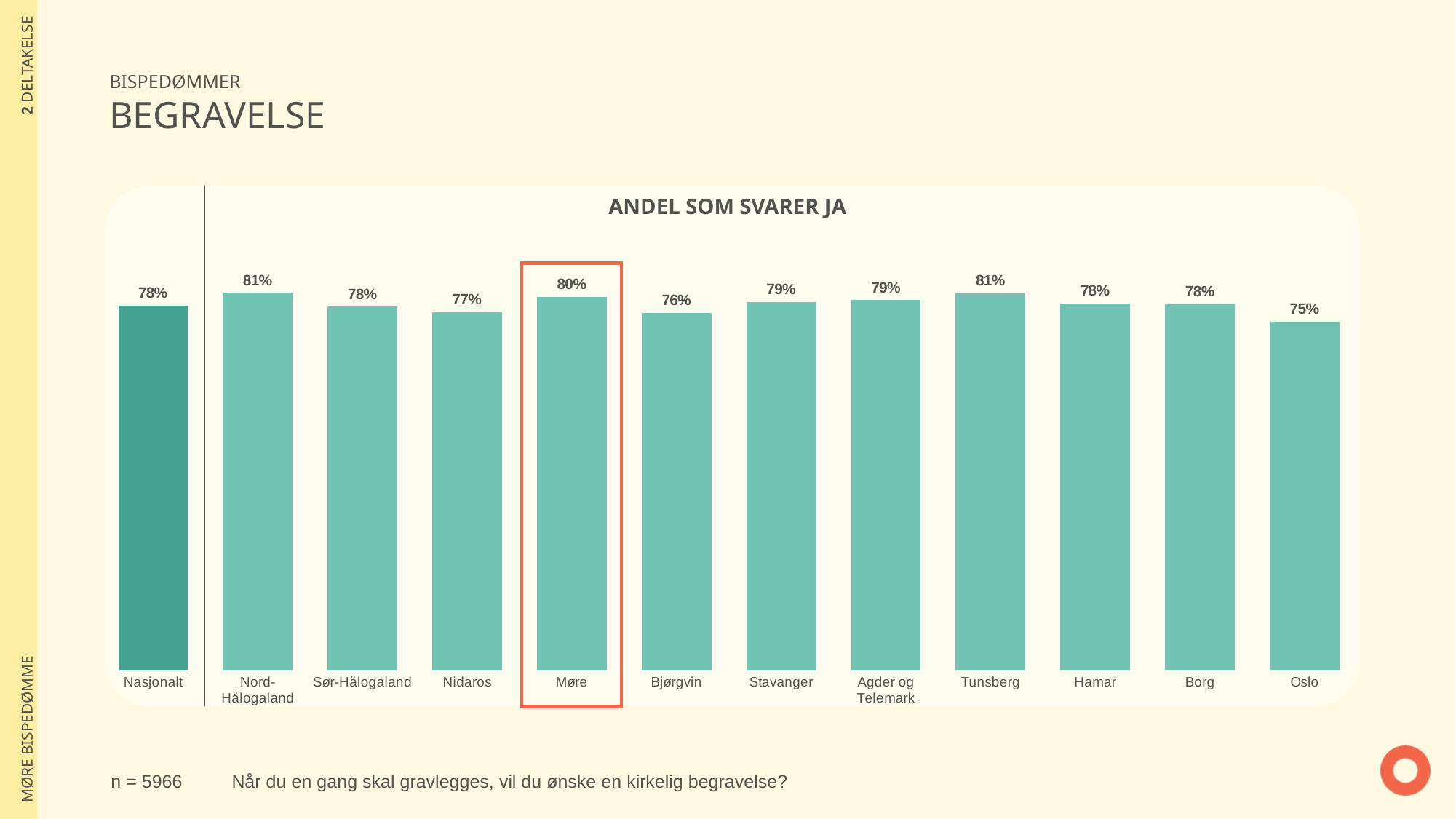
What is the difference between the values for Tunsberg and Oslo? 6% What kind of chart is shown on the slide? Bar chart What is the value for Nasjonalt? 78% What is the value for Møre? 80% Which category is highlighted with an orange box? Møre What is the value for Oslo? 75% What is the difference between the values for Møre and Nasjonalt? 2% What is the value for Agder og Telemark? 79% What is the value for Bjørgvin? 76% Which category has the lowest value? Oslo Which is larger, the value for Nidaros or the value for Stavanger? Stavanger How many bars are shown in the chart? 12